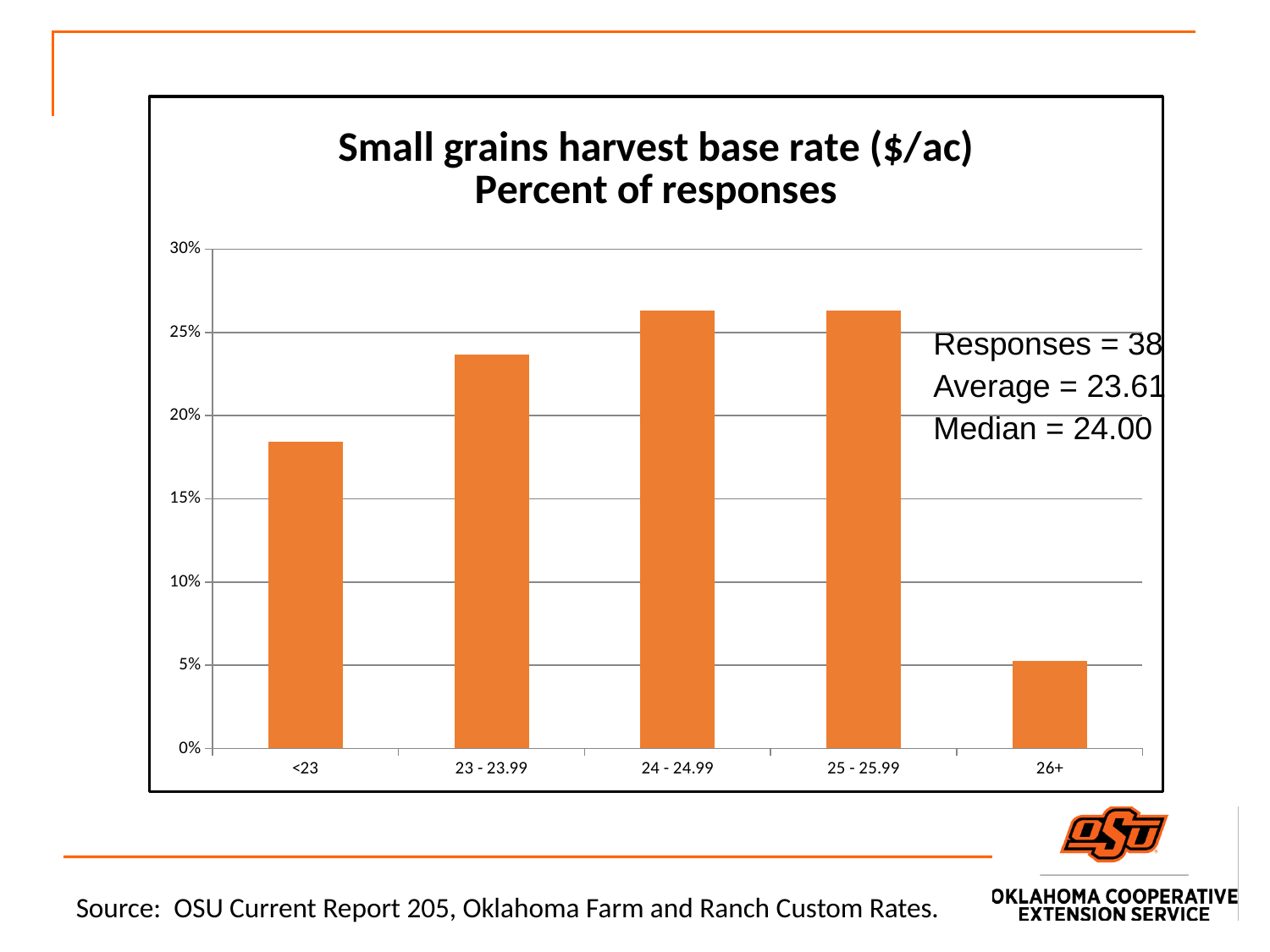
Is the value for <23 greater or less than 20%? less Is the value for 26+ greater or less than 10%? less How many categories are shown on the x axis of the chart? 5 What kind of chart is shown on the slide? bar chart What is the title of the chart? Small grains harvest base rate ($/ac) Percent of responses Which has a higher percent of responses, 25 - 25.99 or 26+? 25 - 25.99 Is the value for 24 - 24.99 greater or less than 25%? greater According to the text on the chart, how many responses were there? 38 Does the percent of responses rise or fall from 25 - 25.99 to 26+? fall Which category has the lowest percent of responses? 26+ Which has a higher percent of responses, <23 or 23 - 23.99? 23 - 23.99